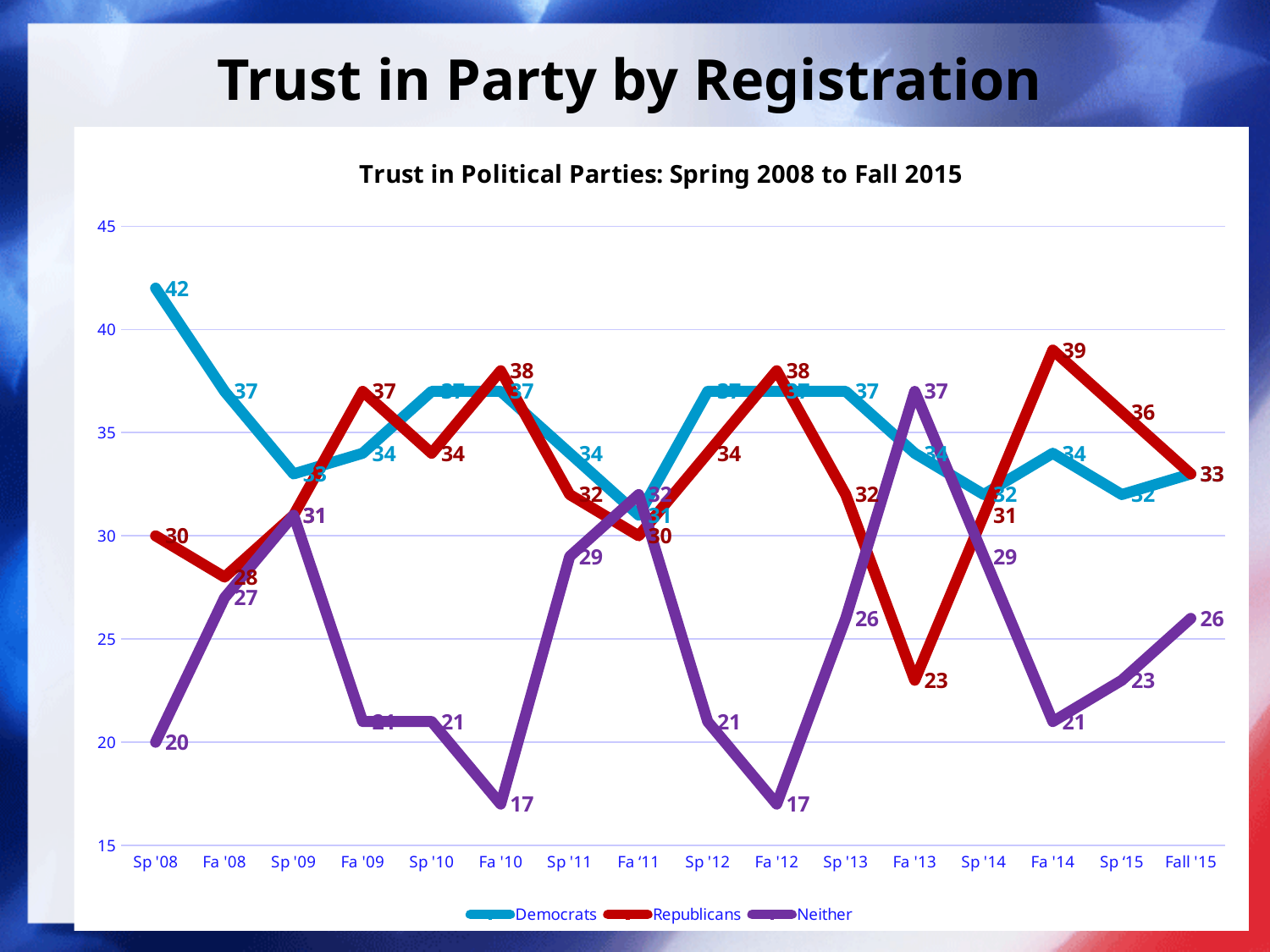
At Sp '08, which is larger: the Democrats value or the Republicans value? Democrats What is the value for Neither at Fa '10? 17 What is the value for Democrats at Sp '08? 42 At which point on the x axis is the Democrats series highest? Sp '08 What kind of chart is shown on the slide? Line chart At which point on the x axis is the Republicans series lowest? Fa '13 How many points are shown along the x axis? 16 How many series does the legend list? 3 What is the difference between the Republicans value and the Neither value at Fa '14? 18 What is the value for Republicans at Fa '14? 39 Does the Democrats series rise or fall from Sp '08 to Sp '09? Fall What is the value for Neither at Fa '13? 37